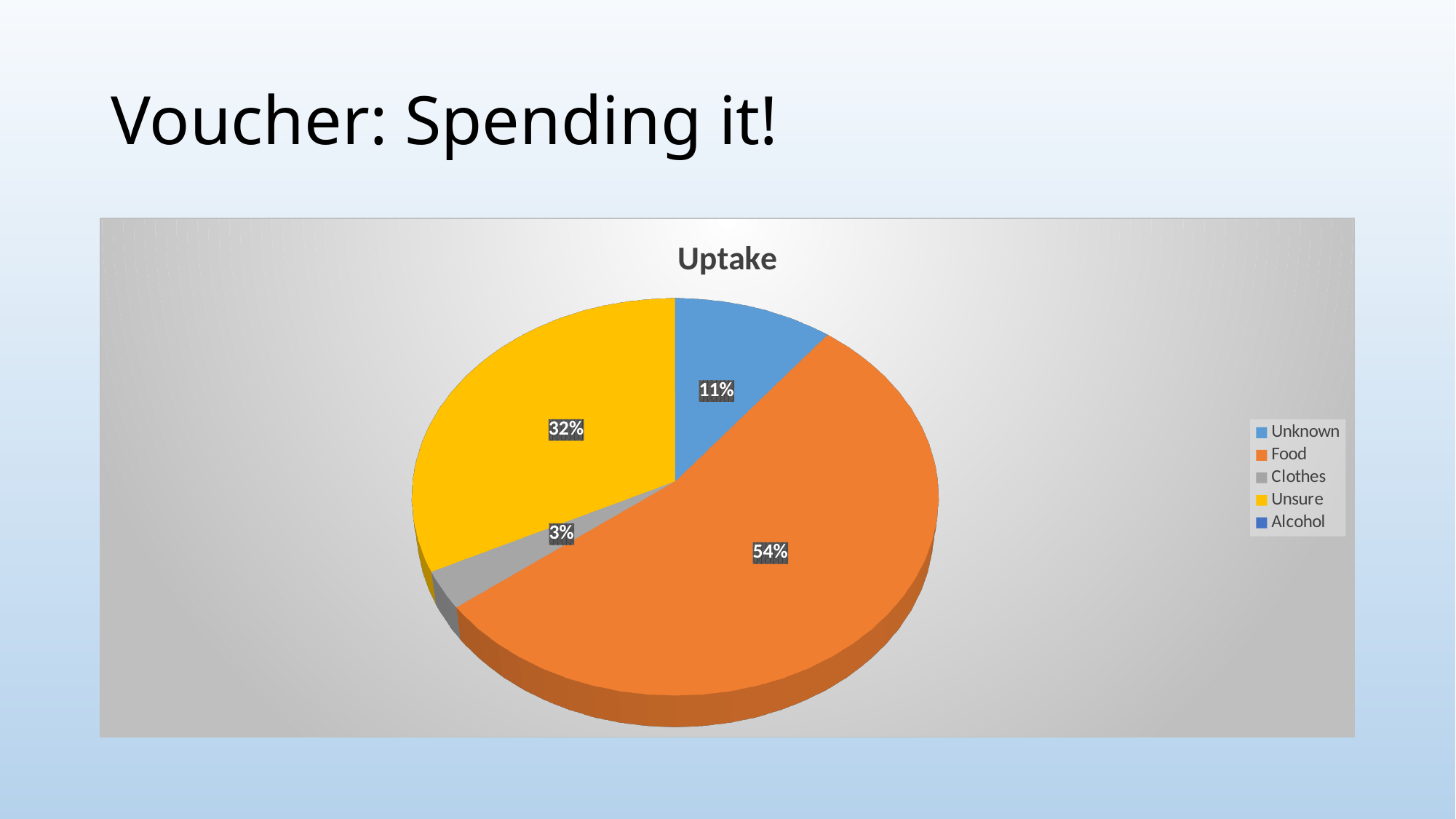
What percentage is shown for the Unsure slice? 32% Which slice is larger, Unsure or Unknown? Unsure What is the title of the chart? Uptake What percentage of the pie is labelled for Food? 54% Which category has the largest slice of the pie? Food What kind of chart is shown on the slide? Pie chart Which of the labelled slices is the smallest? Clothes How many categories does the legend list? 5 What colour represents Food in the pie chart? Orange What percentage is shown for the Unknown slice? 11% By how many percentage points does the Food slice exceed the Unsure slice? 22 percentage points What percentage is shown for the Clothes slice? 3%